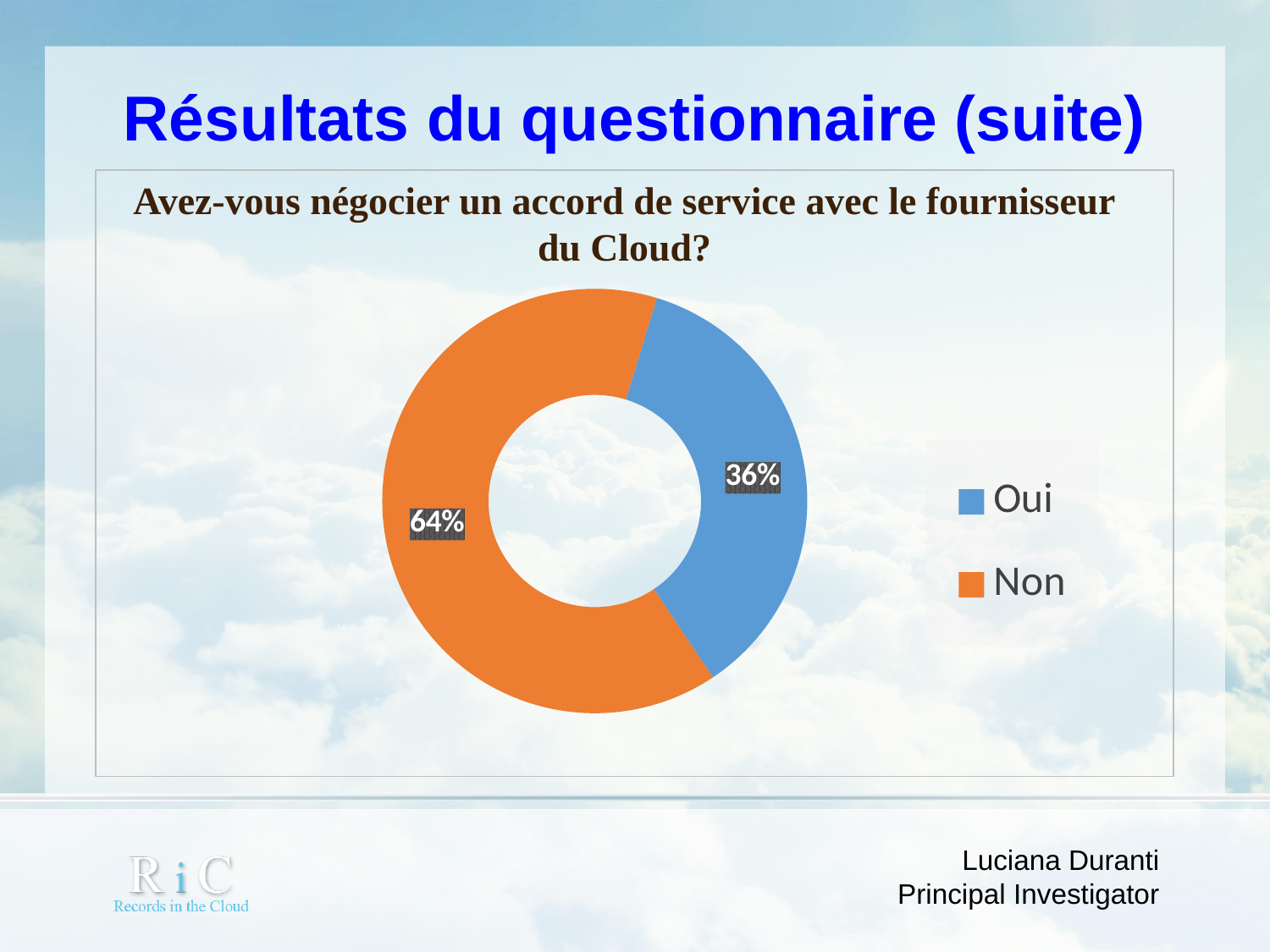
Which response has the largest share of the chart? Non What is the title of the chart? Avez-vous négocier un accord de service avec le fournisseur du Cloud? What percentage of respondents answered "Oui"? 36% What colour represents "Oui" in the chart? Blue Which is larger, the share for "Oui" or the share for "Non"? Non Which response has the smallest share of the chart? Oui What kind of chart is shown on the slide? Doughnut (pie) chart How many categories are shown in the chart? 2 What share of the chart does the "Non" slice represent? 64% What percentage of respondents answered "Non"? 64% How many entries does the legend list? 2 What is the difference in percentage points between the "Non" and "Oui" shares? 28